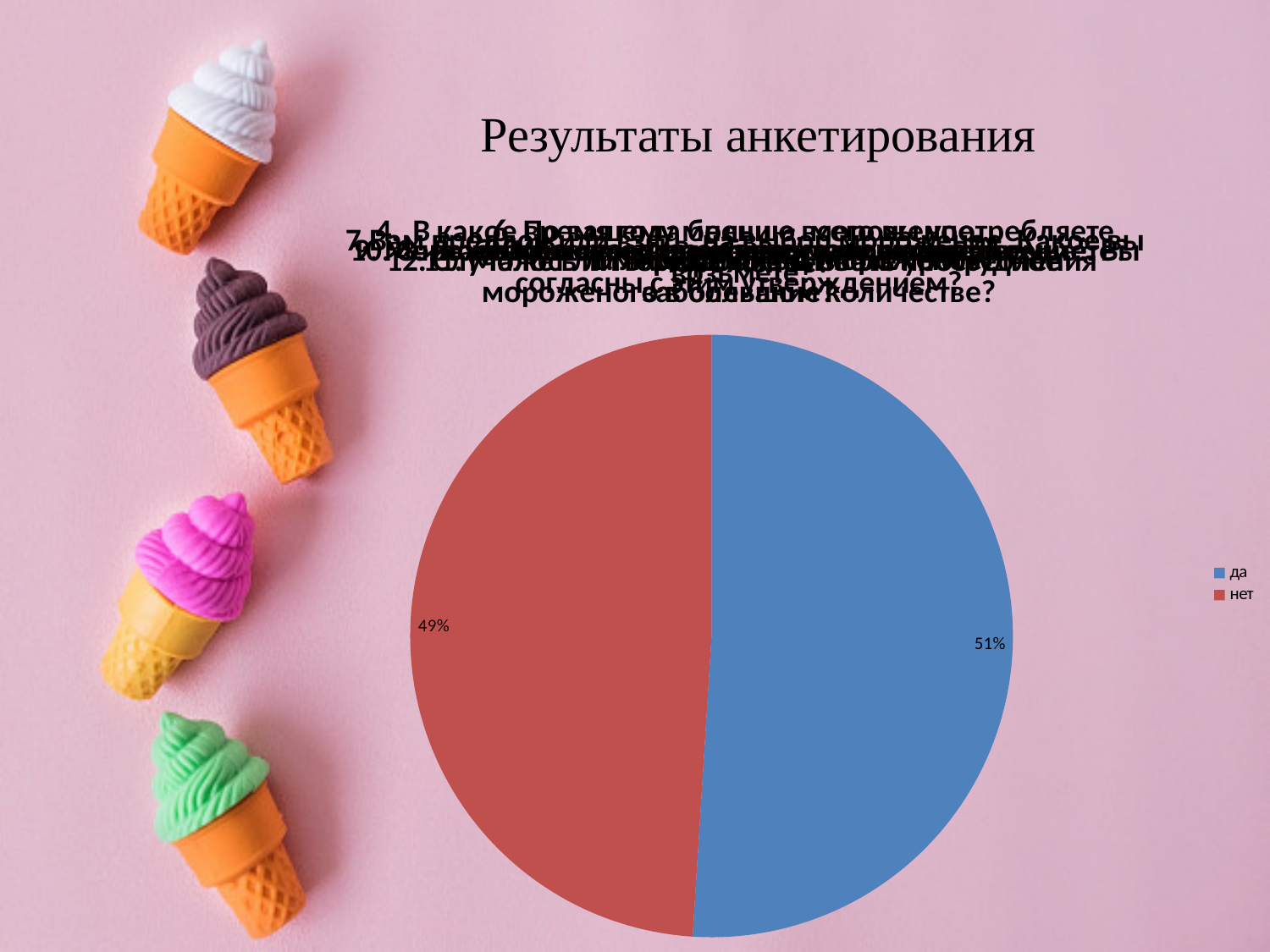
What colour is the "да" slice in the pie chart? blue How many entries does the chart legend list? 2 How many slices does the pie chart have? 2 Is the share for "да" larger or smaller than the share for "нет"? larger Which category has the smaller share of the pie chart? нет Which category has the larger share of the pie chart? да What kind of chart is shown on the slide? pie chart What is the difference in percentage points between the "да" and "нет" slices? 2 percentage points What percentage of the pie chart is labelled "да"? 51% What share of the pie does the "нет" slice represent? 49% What are the two entries listed in the chart legend? да and нет What percentage of the pie chart is labelled "нет"? 49%